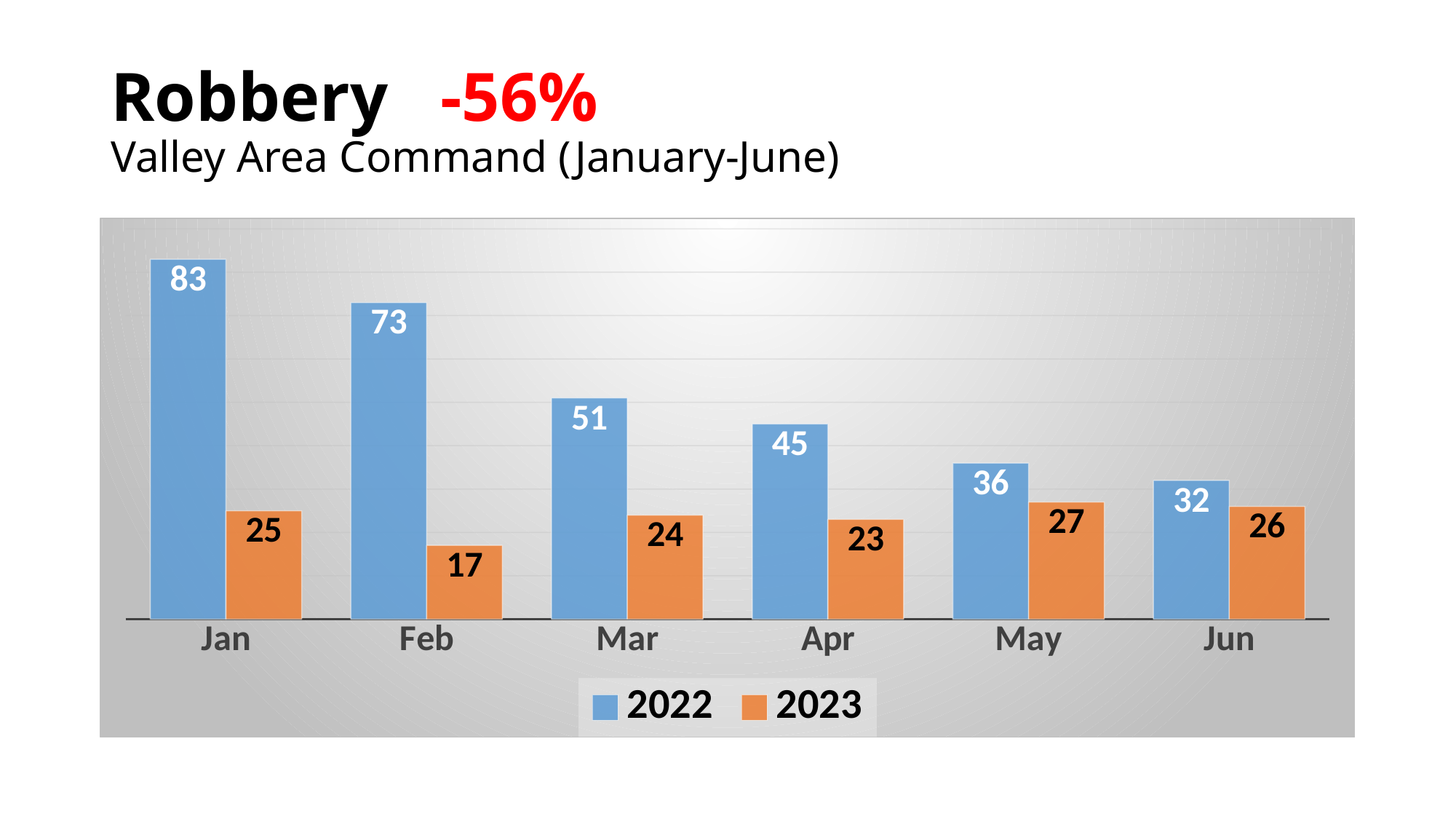
Which is larger, the 2023 value for Apr or the 2023 value for Jun? Jun What is the 2023 value for Feb? 17 Do the 2022 values rise or fall from Jan to Jun? Fall Which month has the lowest 2023 value? Feb How many series does the legend list? 2 What is the difference between the 2022 and 2023 values for Mar? 27 What is the 2023 value for May? 27 What is the 2022 value for Jan? 83 What kind of chart is shown on the slide? Bar chart How many months are shown on the x axis? 6 Which month has the highest 2022 value? Jan What percentage change is shown in red next to the title? -56%